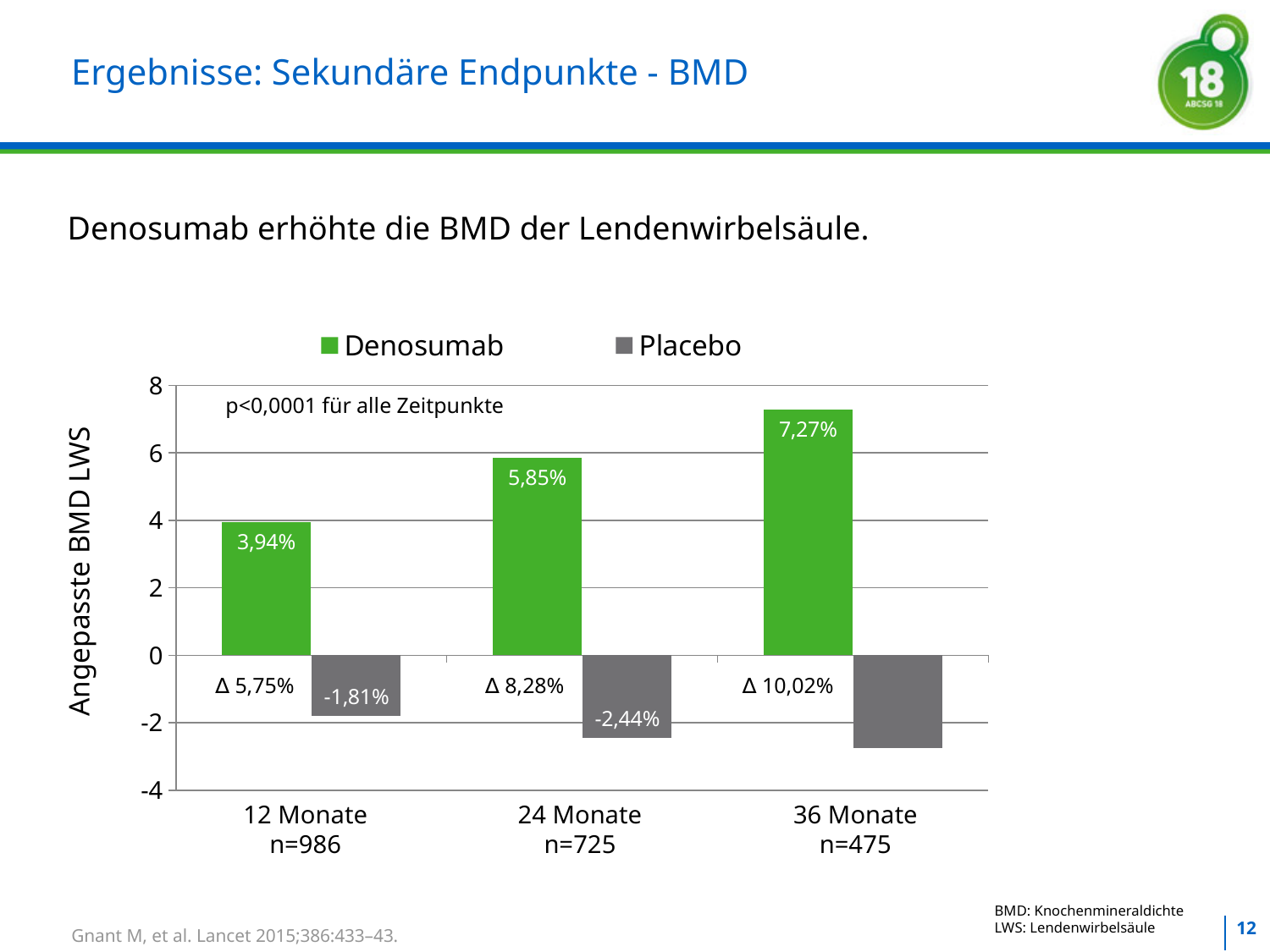
At which time point is the Placebo value lowest? 36 Monate How many time points are shown on the x axis? 3 How many series does the legend list? 2 What is the value for Denosumab at 36 Monate? 7,27% Do the Denosumab values rise or fall from 12 Monate to 36 Monate? rise Which is larger, the Denosumab value at 24 Monate or at 12 Monate? 24 Monate What kind of chart is shown on the slide? bar chart At which time point is the Denosumab value highest? 36 Monate What is the value for Denosumab at 12 Monate? 3,94% What is the difference (Δ) between Denosumab and Placebo at 24 Monate, as printed on the chart? 8,28% Is the value for Placebo at 36 Monate greater or less than -2? less What is the value for Placebo at 24 Monate? -2,44%